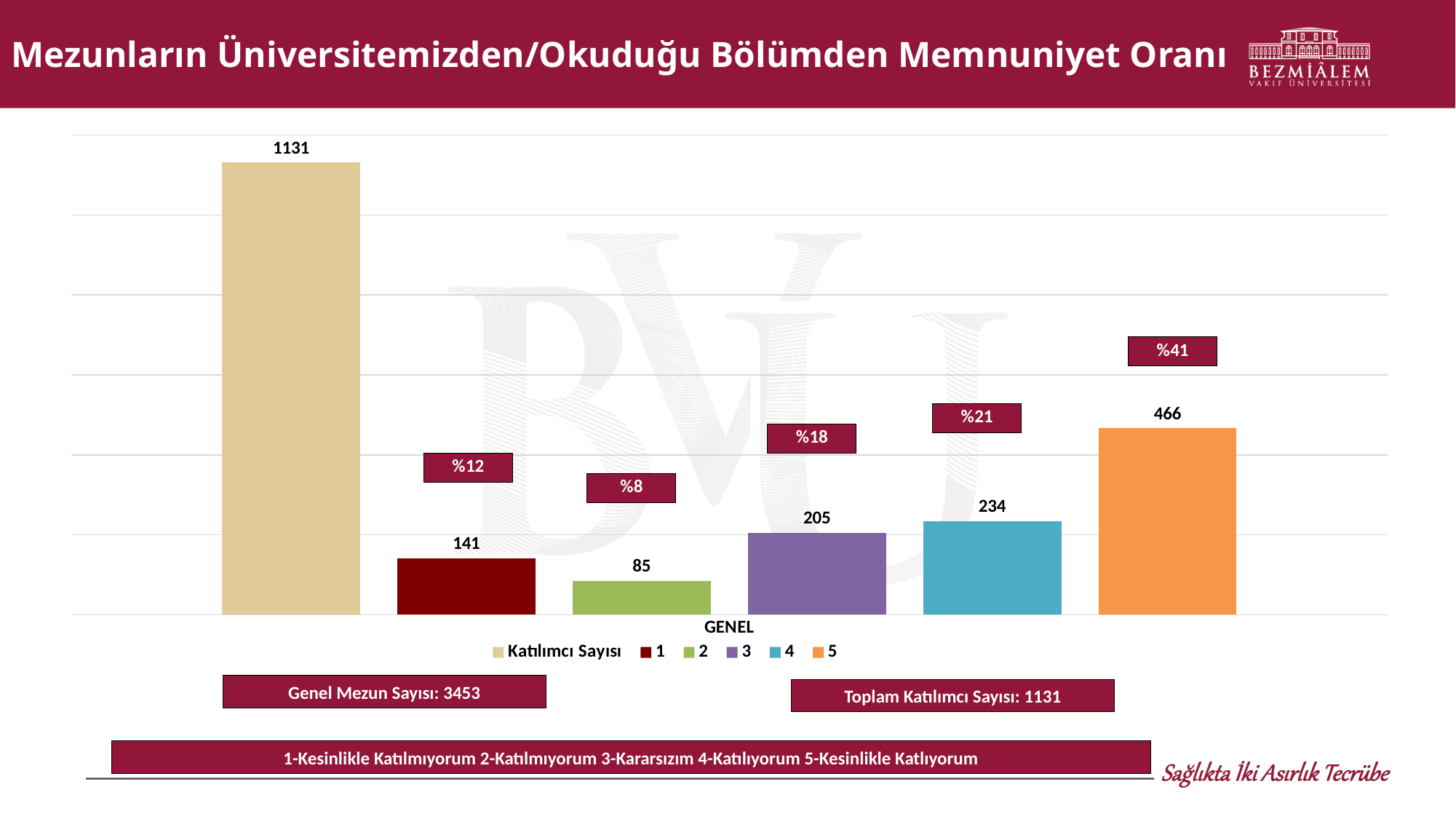
What percentage label is shown above the bar for series 4? %21 Which is larger, the value for series 3 or the value for series 1? series 3 What kind of chart is shown on the slide? bar chart What is the difference between the values for series 5 and series 4? 232 Among the response series 1 to 5, which has the lowest value? 2 How many series does the legend list? 6 What is the value of the Katılımcı Sayısı bar? 1131 What is the value of the bar for series 5? 466 Among the response series 1 to 5, which has the highest value? 5 What is the category label shown on the x axis? GENEL What is the value of the bar for series 1? 141 What is the value of the bar for series 2? 85